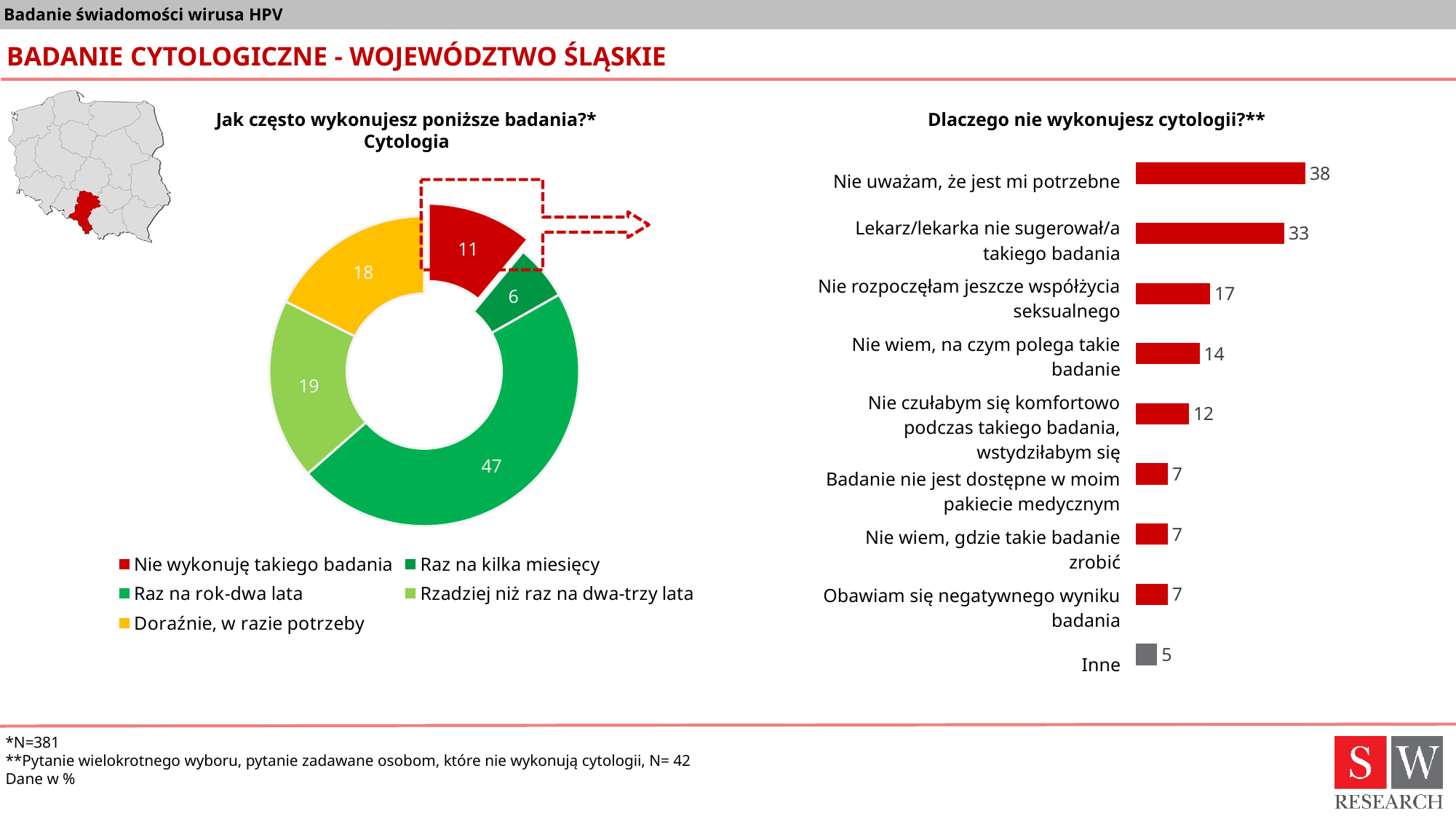
In the donut chart 'Jak często wykonujesz poniższe badania? Cytologia', which colour represents 'Doraźnie, w razie potrzeby'? Yellow In the donut chart 'Jak często wykonujesz poniższe badania? Cytologia', which category has the smallest value? Raz na kilka miesięcy What type of chart is 'Dlaczego nie wykonujesz cytologii?'? Bar chart In the bar chart 'Dlaczego nie wykonujesz cytologii?', which category has the lowest value? Inne In the bar chart 'Dlaczego nie wykonujesz cytologii?', what is the value for 'Nie uważam, że jest mi potrzebne'? 38 In the bar chart 'Dlaczego nie wykonujesz cytologii?', what is the difference between 'Nie uważam, że jest mi potrzebne' and 'Lekarz/lekarka nie sugerował/a takiego badania'? 5 In the donut chart 'Jak często wykonujesz poniższe badania? Cytologia', how many categories does the legend list? 5 In the donut chart 'Jak często wykonujesz poniższe badania? Cytologia', what is the value for 'Raz na rok-dwa lata'? 47 In the donut chart 'Jak często wykonujesz poniższe badania? Cytologia', what is the value for 'Nie wykonuję takiego badania'? 11 In the bar chart 'Dlaczego nie wykonujesz cytologii?', which is larger: 'Nie rozpoczęłam jeszcze współżycia seksualnego' or 'Nie czułabym się komfortowo podczas takiego badania, wstydziłabym się'? Nie rozpoczęłam jeszcze współżycia seksualnego In the bar chart 'Dlaczego nie wykonujesz cytologii?', what is the value for 'Nie wiem, na czym polega takie badanie'? 14 In the donut chart 'Jak często wykonujesz poniższe badania? Cytologia', what is the difference between 'Rzadziej niż raz na dwa-trzy lata' and 'Doraźnie, w razie potrzeby'? 1